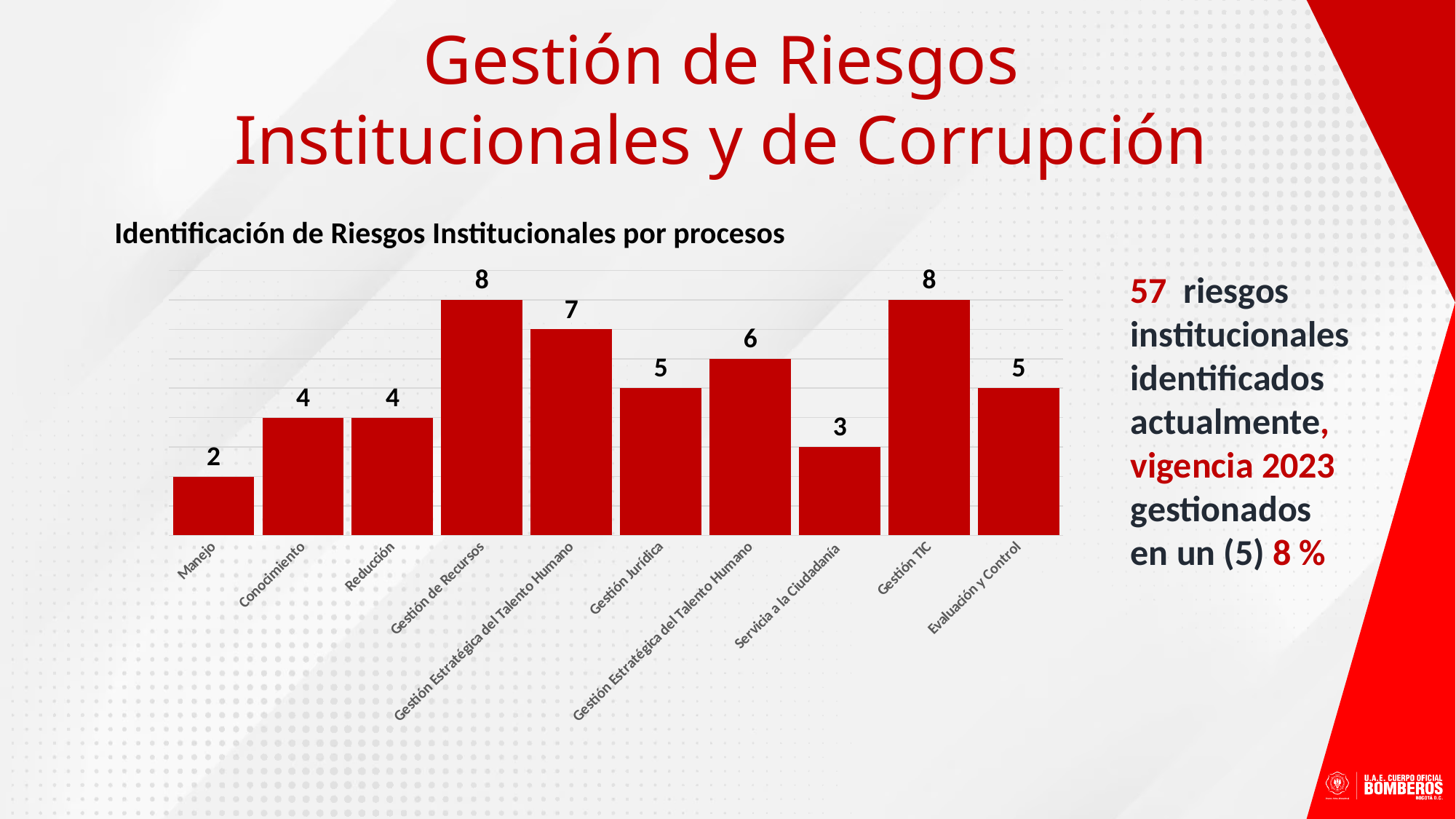
What is the title of the chart? Identificación de Riesgos Institucionales por procesos What kind of chart is shown on the slide? Bar chart Which is larger, the value for Gestión Jurídica or the value for Servicio a la Ciudadanía? Gestión Jurídica What is the difference between the values for Evaluación y Control and Manejo? 3 What is the value for Gestión de Recursos? 8 How many categories are shown on the x axis? 10 What is the value for Servicio a la Ciudadanía? 3 What is the value for Manejo? 2 Which category has the lowest value? Manejo What is the value for Gestión Jurídica? 5 What is the value for Gestión TIC? 8 What is the difference between the values for Gestión de Recursos and Servicio a la Ciudadanía? 5